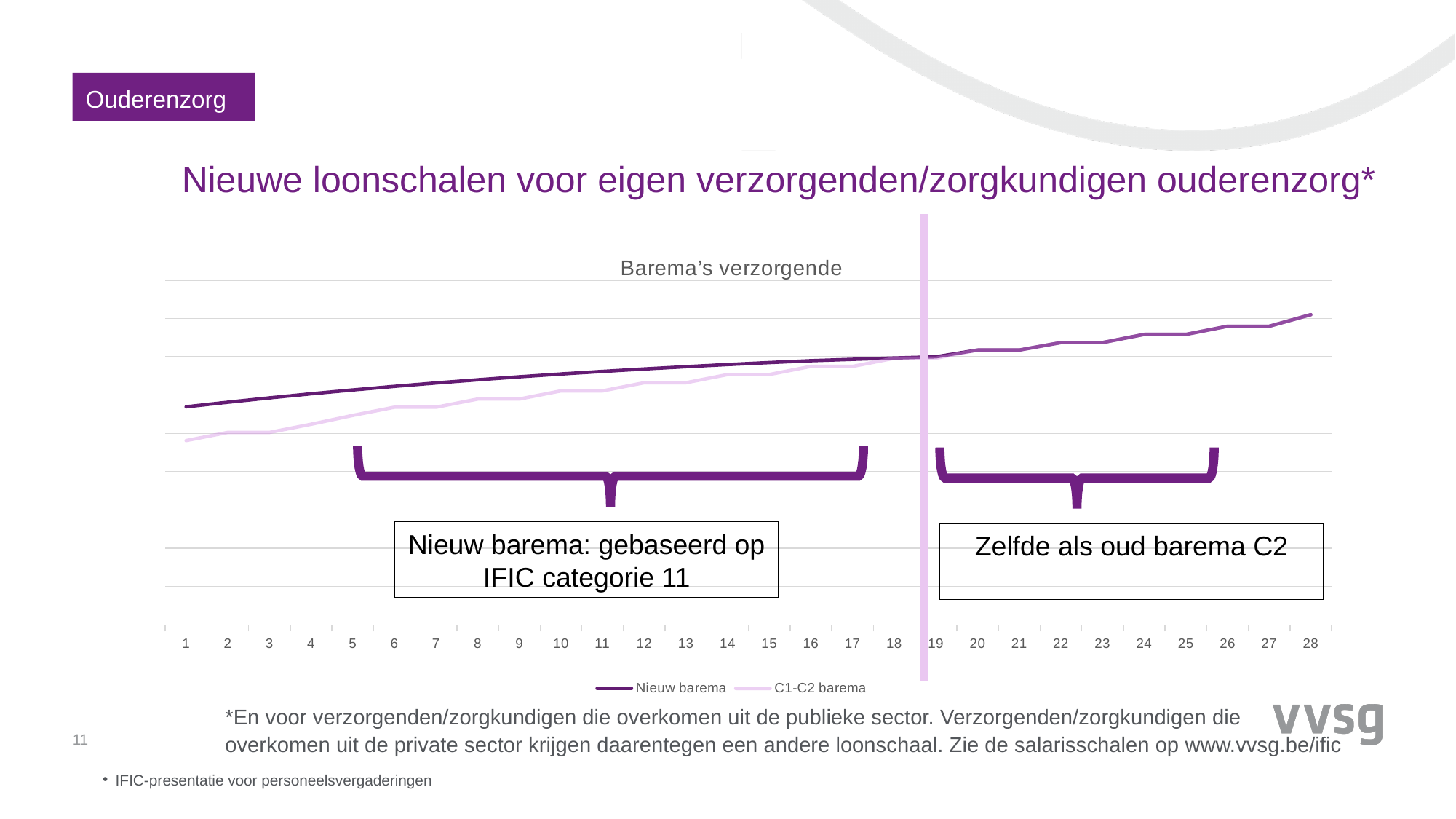
At which x value is the "C1-C2 barema" series at its lowest? 1 How many series does the legend of the "Barema's verzorgende" chart list? 2 What kind of chart is shown under the title "Barema's verzorgende"? line chart What are the two series named in the legend of the "Barema's verzorgende" chart? Nieuw barema and C1-C2 barema Do the values of the "Nieuw barema" series rise or fall from x = 1 to x = 28? rise Do the values of the "C1-C2 barema" series rise or fall along the x axis? rise How many points are shown along the x axis of the "Barema's verzorgende" chart? 28 At x = 10, which series is lower: "Nieuw barema" or "C1-C2 barema"? C1-C2 barema At x = 1, which series has the higher value: "Nieuw barema" or "C1-C2 barema"? Nieuw barema At which x value does the "Nieuw barema" series reach its highest point? 28 What is the title of the chart on the slide? Barema's verzorgende At which x value does the "Nieuw barema" series have its lowest value? 1